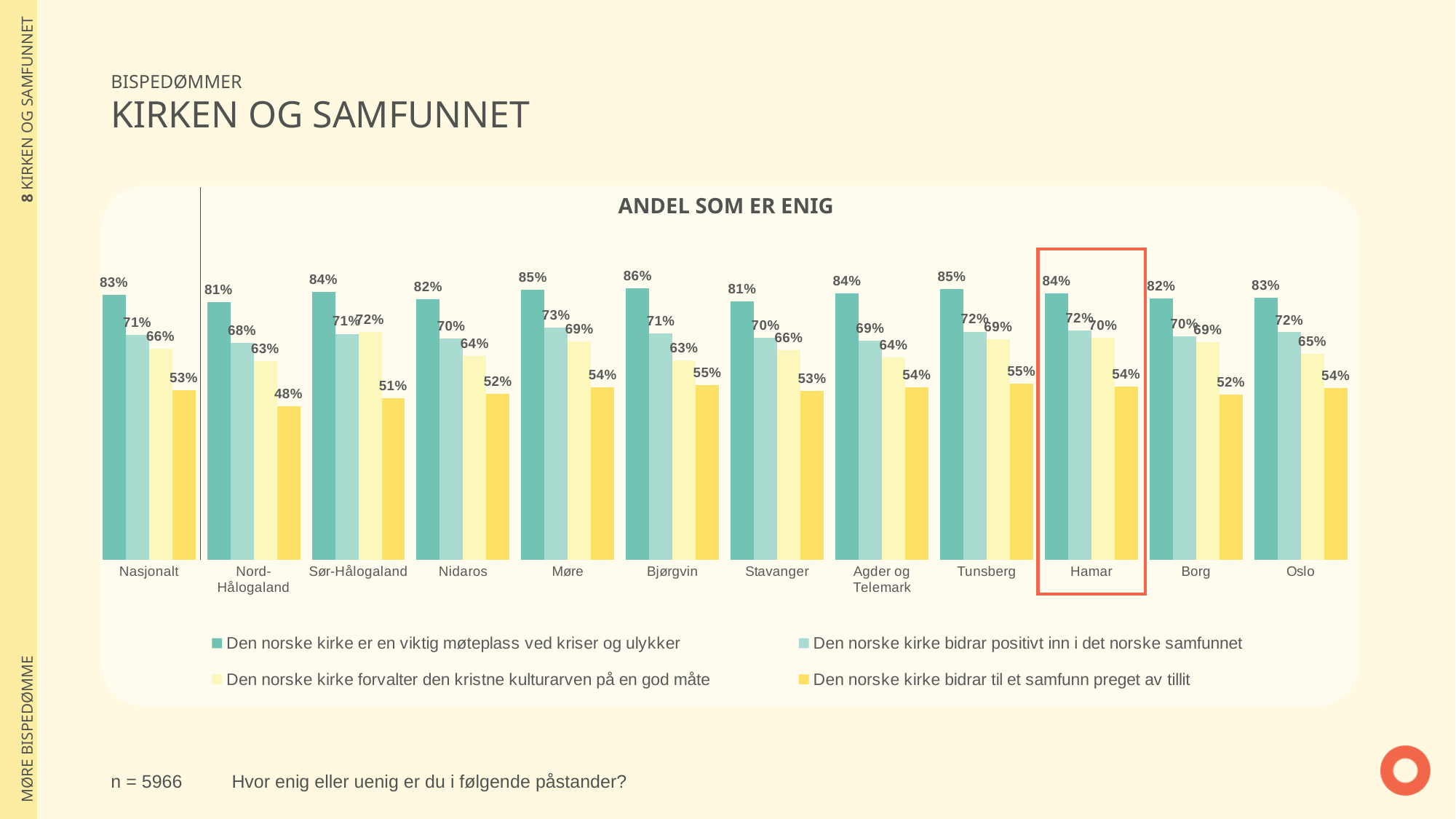
Which is larger: the value for Nord-Hålogaland or for Oslo in the series 'Den norske kirke bidrar til et samfunn preget av tillit'? Oslo What is the value for Nasjonalt in the series 'Den norske kirke er en viktig møteplass ved kriser og ulykker'? 83% What is the difference between the Nasjonalt values for 'Den norske kirke er en viktig møteplass ved kriser og ulykker' and 'Den norske kirke bidrar til et samfunn preget av tillit'? 30 percentage points What is the value for Hamar in the series 'Den norske kirke bidrar til et samfunn preget av tillit'? 54% Which category has the lowest value in the series 'Den norske kirke bidrar til et samfunn preget av tillit'? Nord-Hålogaland How many categories are shown along the x axis? 12 What kind of chart is shown on the slide? bar chart What is the value for Sør-Hålogaland in the series 'Den norske kirke forvalter den kristne kulturarven på en god måte'? 72% Which category has the highest value in the series 'Den norske kirke bidrar positivt inn i det norske samfunnet'? Møre How many series does the legend list? 4 Which category has the highest value in the series 'Den norske kirke er en viktig møteplass ved kriser og ulykker'? Bjørgvin What is the title of the chart? ANDEL SOM ER ENIG